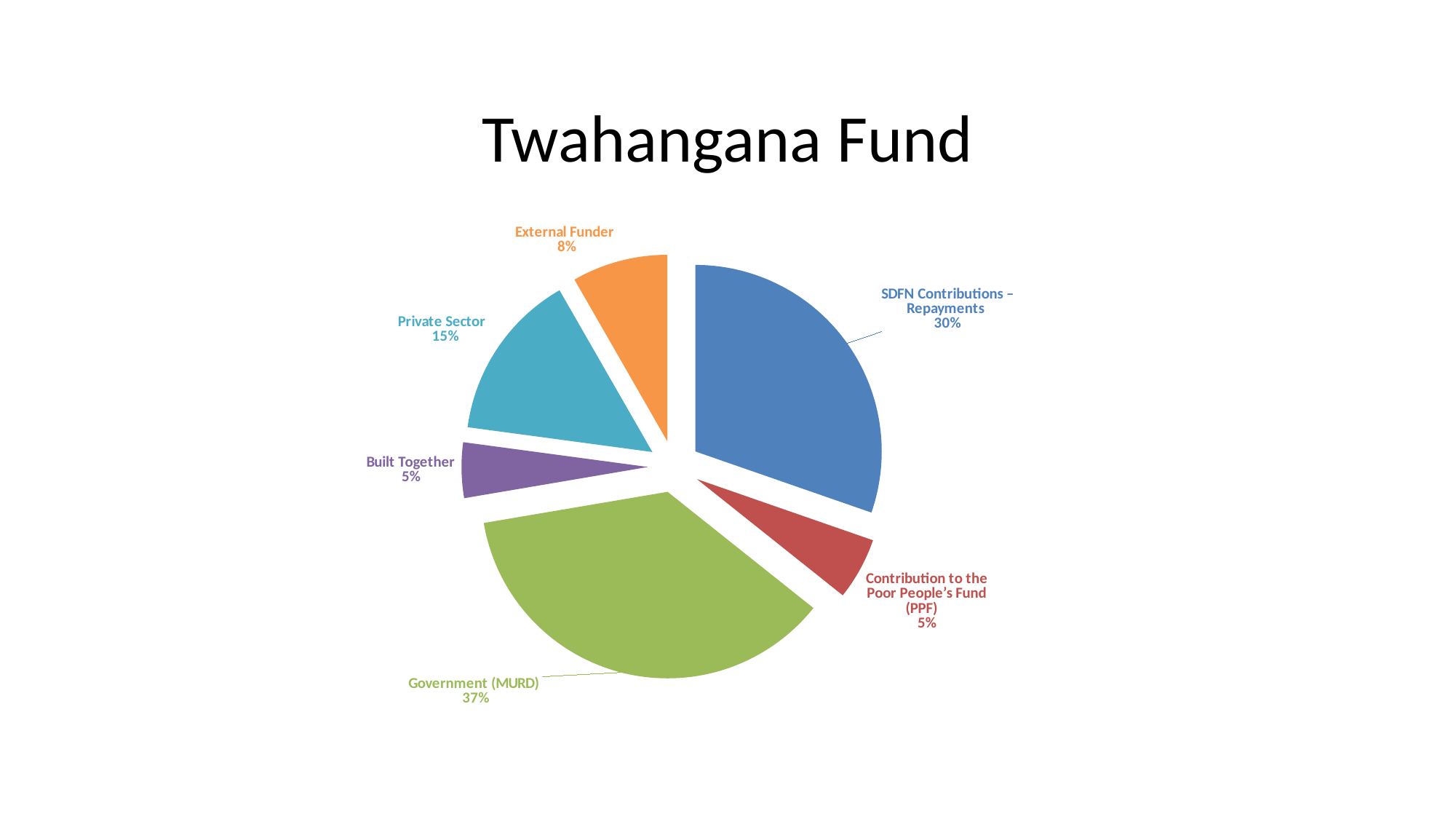
How many slices does the pie chart have? 6 What share of the Twahangana Fund comes from Built Together? 5% What is the title of the slide containing the pie chart? Twahangana Fund What kind of chart is shown on the slide? pie chart What is the combined share of Built Together and Contribution to the Poor People's Fund (PPF)? 10% Which source contributes the largest share of the Twahangana Fund? Government (MURD) What share of the Twahangana Fund comes from the External Funder? 8% What share of the Twahangana Fund comes from SDFN Contributions – Repayments? 30% What share of the Twahangana Fund comes from the Private Sector? 15% What is the difference in percentage points between Government (MURD) and SDFN Contributions – Repayments? 7 What share of the Twahangana Fund comes from Government (MURD)? 37% Which is larger, the Private Sector share or the External Funder share? Private Sector